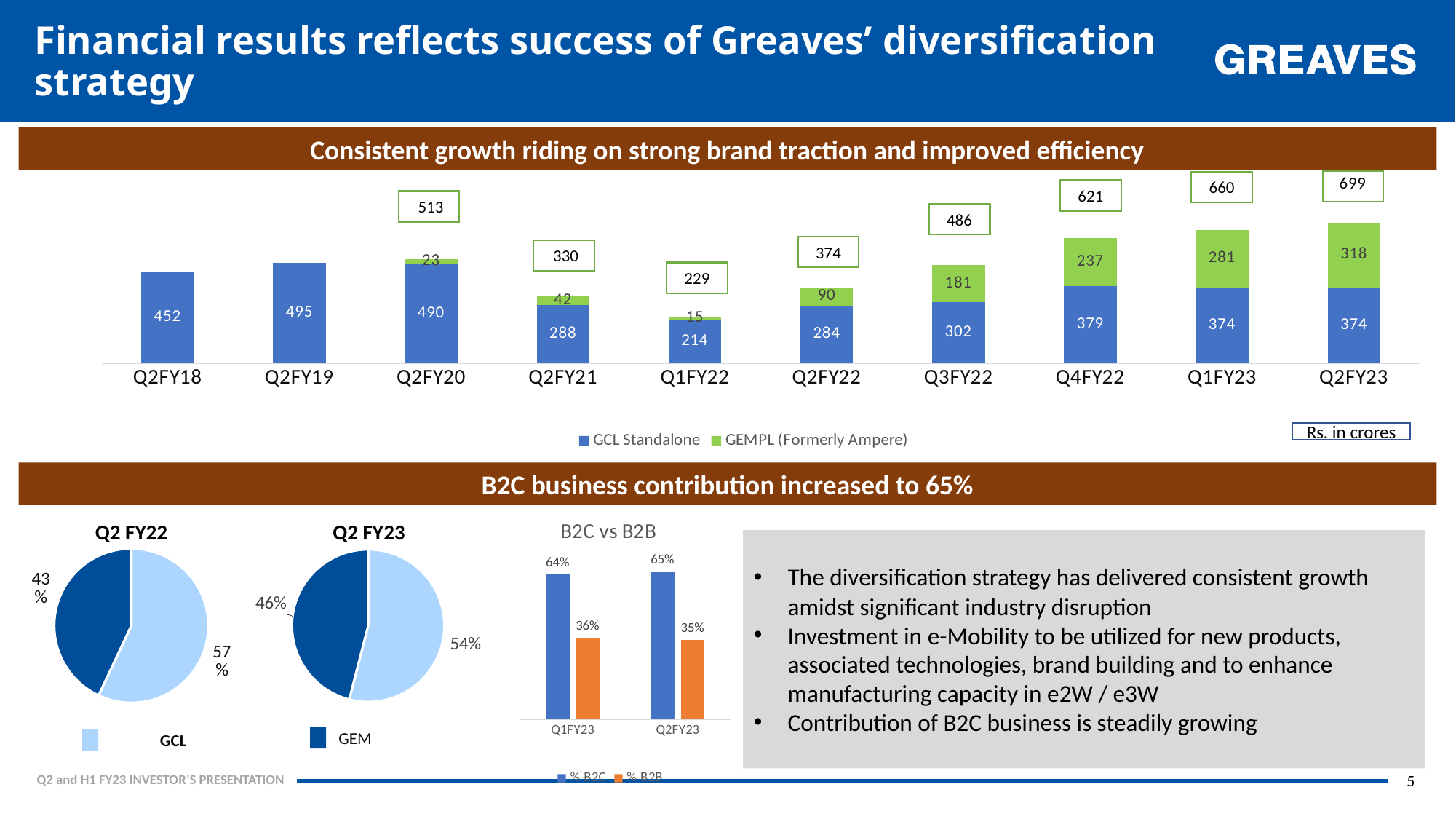
In the top stacked bar chart, which quarter has the lowest GCL Standalone value? Q1FY22 In the top stacked bar chart, what is the difference between the GEMPL (Formerly Ampere) values for Q2FY23 and Q1FY23? 37 In the Q2 FY22 pie chart, which is larger, GCL or GEM? GCL In the top stacked bar chart, what is the GCL Standalone value for Q2FY18? 452 How many series does the legend of the top stacked bar chart list? 2 In the B2C vs B2B chart, what is the % B2C value for Q2FY23? 65% In the Q2 FY23 pie chart, what share does GEM have? 46% How many quarters are shown on the x axis of the top stacked bar chart? 10 In the top stacked bar chart, what is the total printed above the Q2FY23 bar? 699 In the top stacked bar chart, which quarter has the highest GEMPL (Formerly Ampere) value? Q2FY23 What kind of chart is the top chart under 'Consistent growth riding on strong brand traction and improved efficiency'? Stacked bar chart In the top stacked bar chart, what is the GEMPL (Formerly Ampere) value for Q2FY23? 318